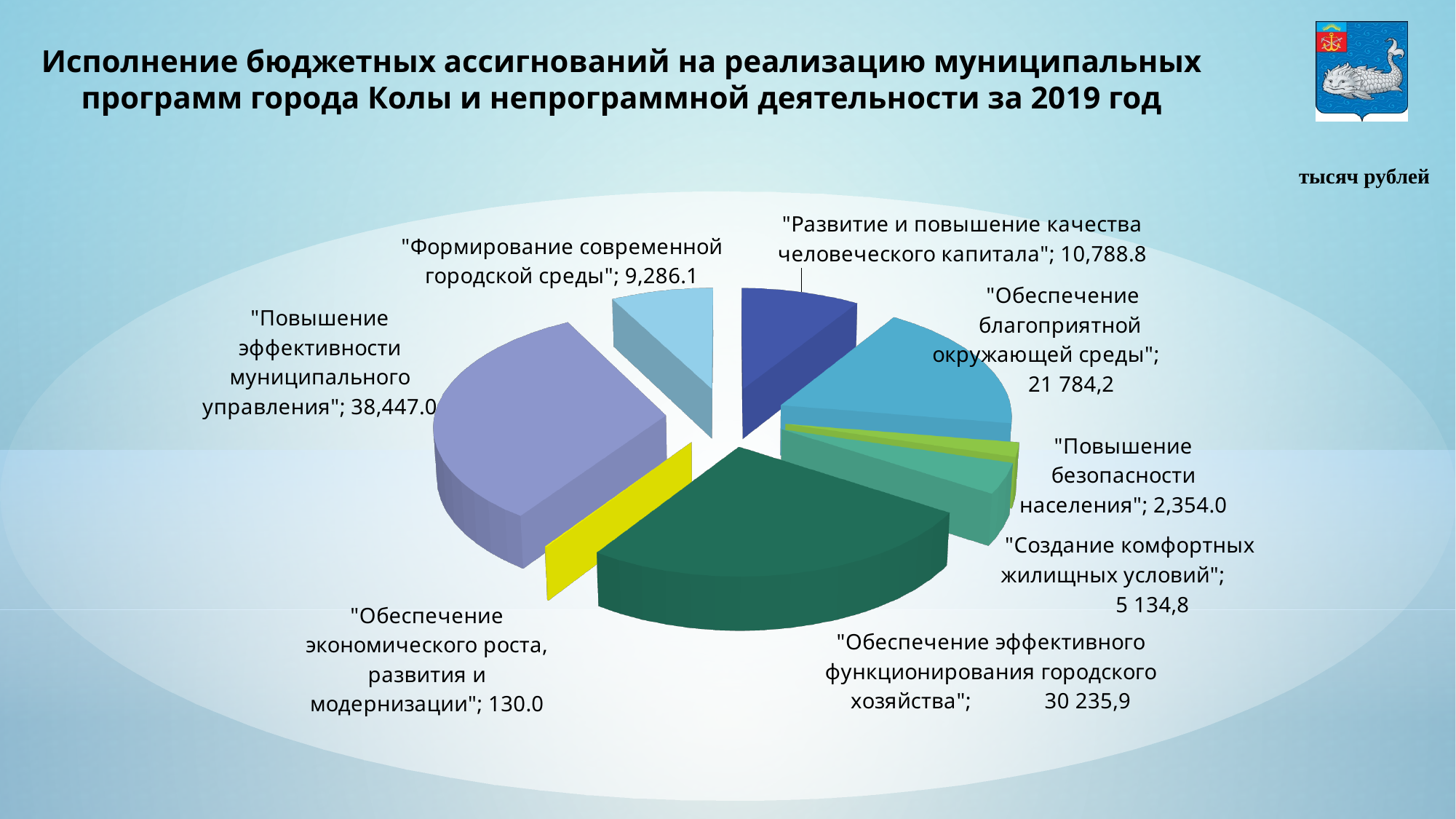
What kind of chart is shown on the slide? pie chart Which program has the largest slice of the pie? "Повышение эффективности муниципального управления" What is the value for "Формирование современной городской среды"? 9,286.1 What is the value for "Повышение безопасности населения"? 2,354.0 Which program has the smallest slice of the pie? "Обеспечение экономического роста, развития и модернизации" In what units are the values on the chart given, according to the slide? тысяч рублей How many slices does the pie chart have? 8 What is the difference between the values for "Повышение безопасности населения" and "Обеспечение экономического роста, развития и модернизации"? 2,224.0 What is the value for "Обеспечение эффективного функционирования городского хозяйства"? 30 235,9 What is the difference between the values for "Развитие и повышение качества человеческого капитала" and "Формирование современной городской среды"? 1,502.7 Which is larger: the value for "Обеспечение благоприятной окружающей среды" or for "Обеспечение эффективного функционирования городского хозяйства"? "Обеспечение эффективного функционирования городского хозяйства" What is the value for "Повышение эффективности муниципального управления"? 38,447.0